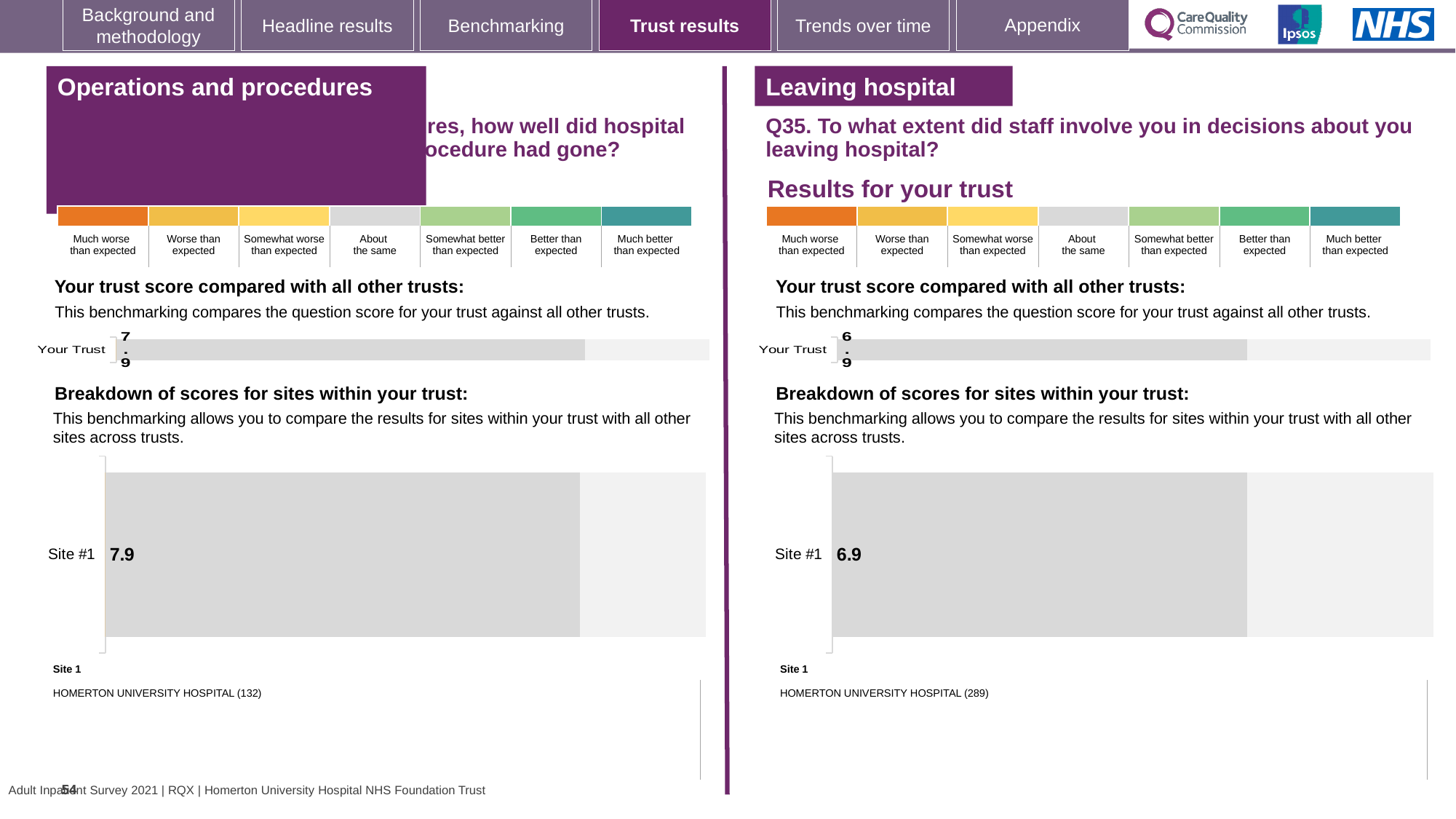
Which is larger: the Site #1 score in the left 'Operations and procedures' breakdown chart or the Site #1 score in the right 'Leaving hospital' breakdown chart? Operations and procedures (7.9) In the 'Operations and procedures' section on the left, what score is shown for Site #1 in the breakdown of scores chart? 7.9 In the 'Operations and procedures' section on the left, what is the score shown for 'Your Trust' in the trust score chart? 7.9 What is the difference between the 'Your Trust' score in the left 'Operations and procedures' chart and the 'Your Trust' score in the right 'Leaving hospital' chart? 1.0 What kind of chart is used to show the Site #1 score in the 'Leaving hospital' breakdown of scores? Bar chart How many sites are shown in the breakdown of scores chart in the 'Leaving hospital' section? 1 In the 'Leaving hospital' section on the right, what is the score shown for 'Your Trust' in the trust score chart? 6.9 In the 'Leaving hospital' section on the right, what score is shown for Site #1 in the breakdown of scores chart? 6.9 In the 'Operations and procedures' section, which hospital is listed as Site 1 below the breakdown chart? HOMERTON UNIVERSITY HOSPITAL (132) Is the Site #1 score in the right 'Leaving hospital' breakdown chart the same as the 'Your Trust' score in that section's trust score chart? Yes, both are 6.9 How many sites are shown in the breakdown of scores chart in the 'Operations and procedures' section? 1 In the 'Leaving hospital' section, which hospital is listed as Site 1 below the breakdown chart? HOMERTON UNIVERSITY HOSPITAL (289)